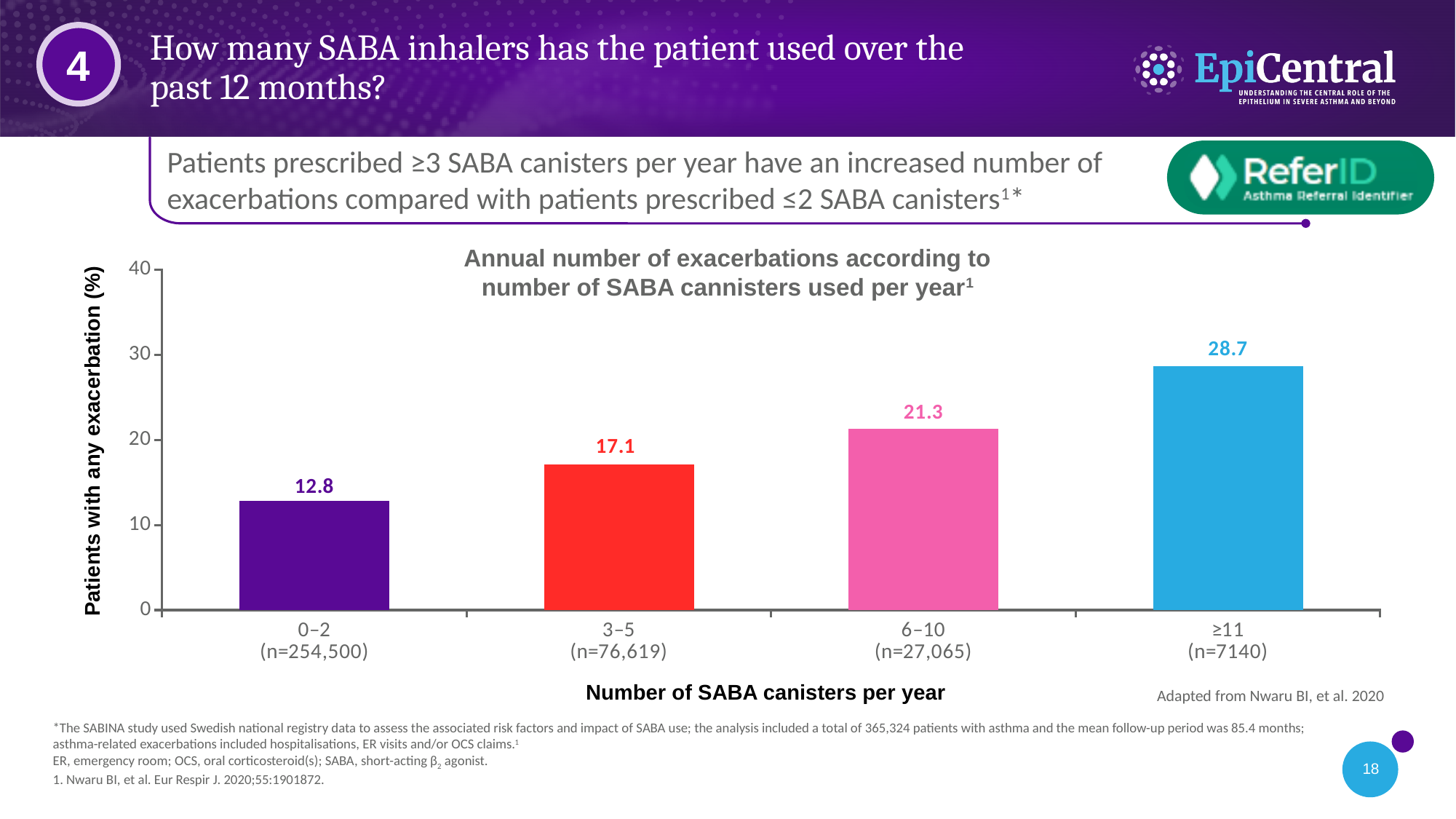
What is the difference in percentage points between the ≥11 and 0–2 canister categories? 15.9 What percentage of patients with 0–2 SABA canisters per year had any exacerbation? 12.8 How many SABA canister categories are shown on the x axis? 4 What is the value shown for the ≥11 SABA canisters per year category? 28.7 Which SABA canister category has the lowest percentage of patients with any exacerbation? 0–2 Which SABA canister category has the highest percentage of patients with any exacerbation? ≥11 Do the values rise or fall as the number of SABA canisters per year increases? Rise What type of chart is used to show the annual number of exacerbations? Bar chart Which category has a larger value, 3–5 canisters or 6–10 canisters? 6–10 What is the value shown for the 3–5 SABA canisters per year category? 17.1 Is the value for the ≥11 canisters category greater or less than 30? less What is the value shown for the 6–10 SABA canisters per year category? 21.3